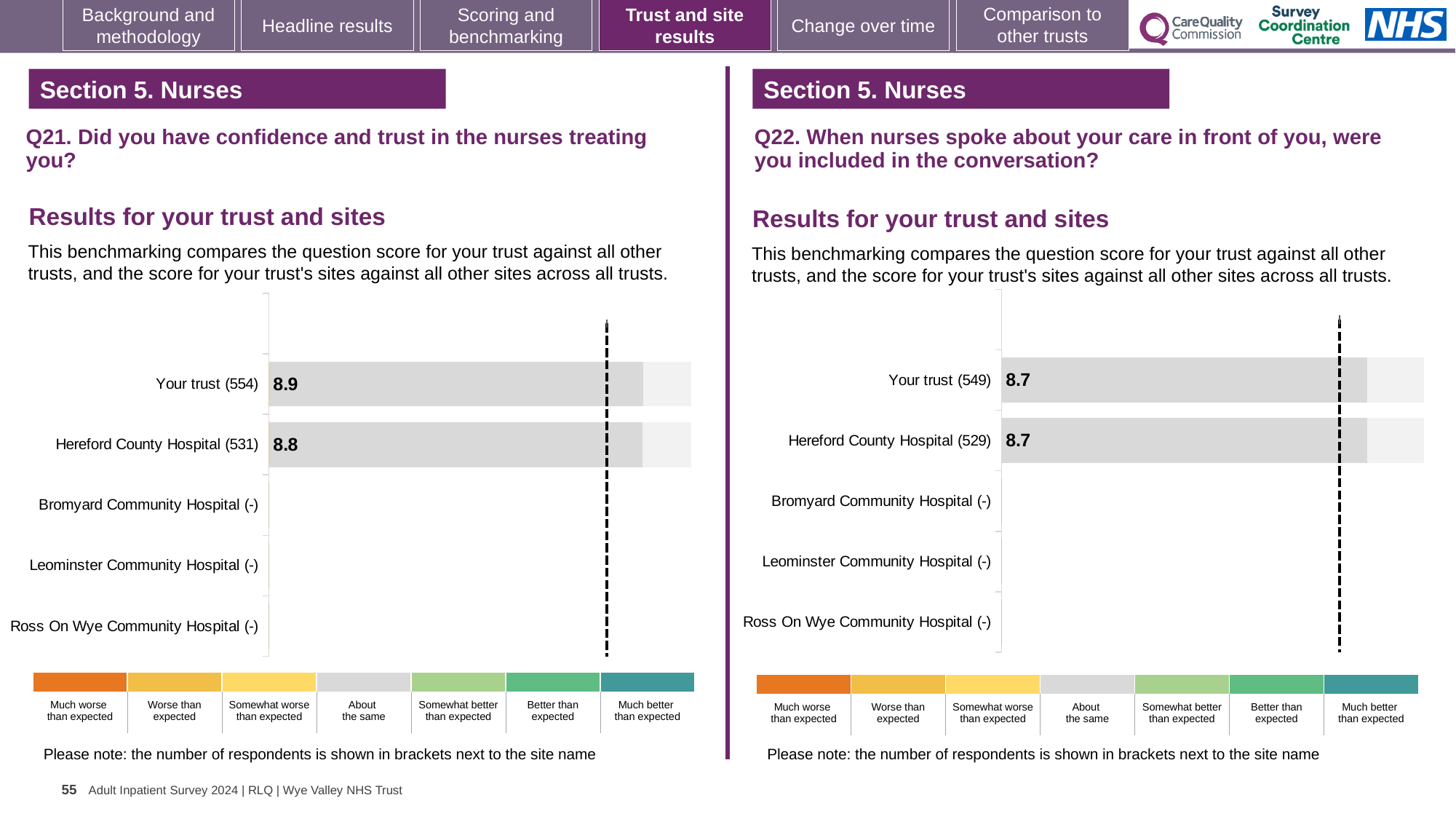
In the Q22 chart on the right, how many categories have no bar plotted (shown with a dash)? 3 In the Q22 chart on the right, what is the score for Your trust? 8.7 In the Q21 chart on the left, which has the higher score, Your trust or Hereford County Hospital? Your trust How many site or trust categories are listed on the y axis of the Q21 chart on the left? 5 In the Q22 chart on the right, what is the score for Hereford County Hospital? 8.7 In the Q21 chart on the left, what is the score for Your trust? 8.9 In the Q22 chart on the right, how many respondents are shown in brackets for Hereford County Hospital? 529 In the Q21 chart on the left, what is the score for Hereford County Hospital? 8.8 In the Q21 chart on the left, what is the difference between the score for Your trust and the score for Hereford County Hospital? 0.1 How many categories does the colour key below the Q21 chart on the left list? 7 In the Q21 chart on the left, how many respondents are shown in brackets for Your trust? 554 What kind of chart is the Q22 chart on the right? Bar chart